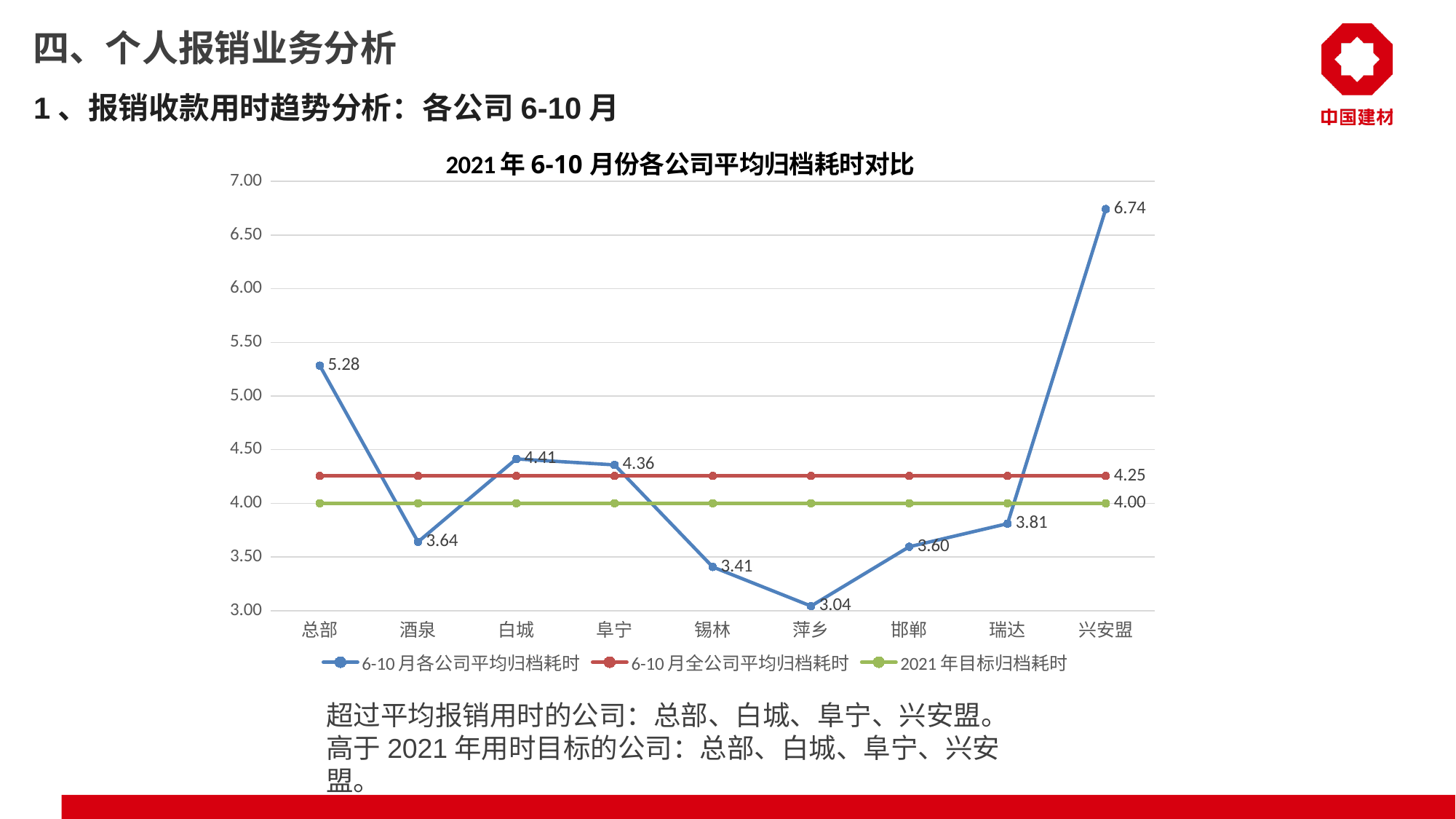
What type of chart is shown on the slide? line chart Which company has the highest average archiving time? 兴安盟 Which company has the lowest average archiving time? 萍乡 What is the difference between the value for 总部 and the all-company average of 4.25? 1.03 How many companies are shown on the x axis? 9 Is the value for 瑞达 greater or less than 4.00? less How many series does the legend list? 3 What is the average archiving time for 兴安盟 in the chart? 6.74 Which is larger, the value for 白城 or the value for 阜宁? 白城 What value is shown for 总部? 5.28 What is the average archiving time for 萍乡? 3.04 What is the difference between the values for 兴安盟 and 萍乡? 3.70